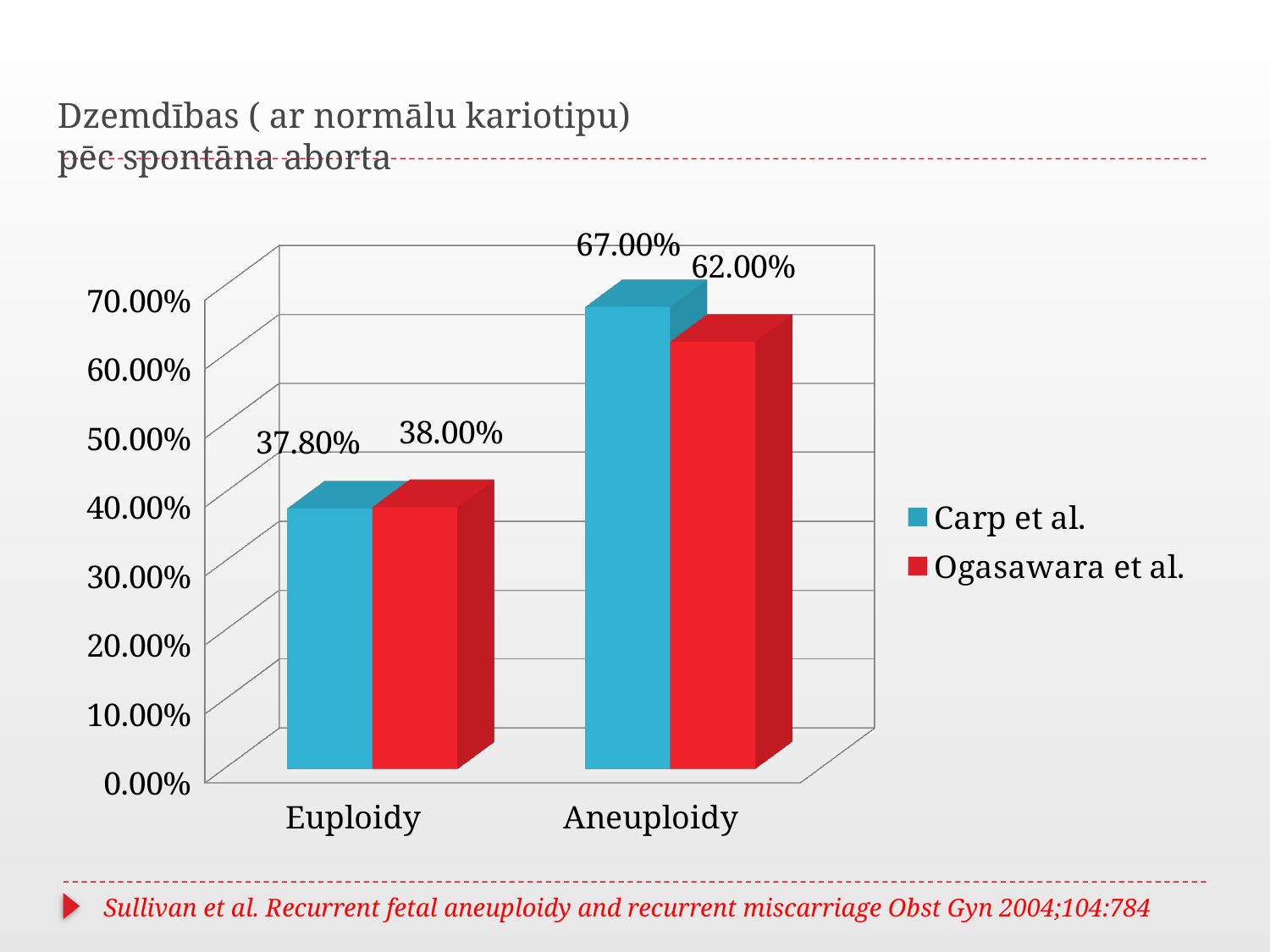
What is the difference between the Carp et al. and Ogasawara et al. values in the Aneuploidy category? 5.00% What is the value for Ogasawara et al. in the Euploidy category? 38.00% Is the value for Carp et al. in the Aneuploidy category greater or less than 60.00%? greater In the Aneuploidy category, which series has the larger value, Carp et al. or Ogasawara et al.? Carp et al. What is the value for Carp et al. in the Euploidy category? 37.80% How many categories are shown on the x axis? 2 What kind of chart is shown on the slide? Bar chart Which category has the highest value for Carp et al.? Aneuploidy Which category has the lowest value for Ogasawara et al.? Euploidy What is the value for Ogasawara et al. in the Aneuploidy category? 62.00% How many series does the legend list? 2 What is the value for Carp et al. in the Aneuploidy category? 67.00%